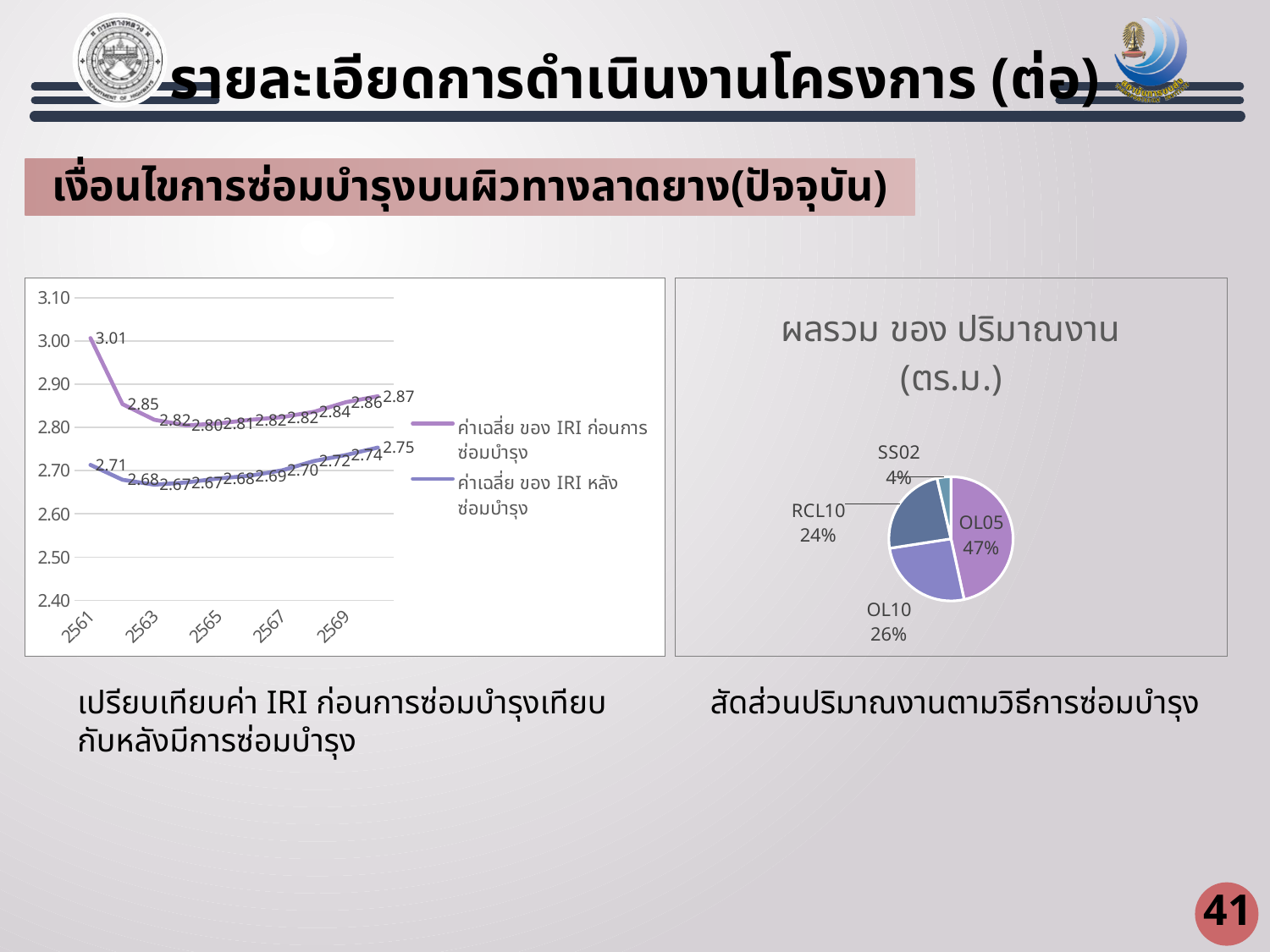
In the pie chart on the right, what share does OL05 have? 47% In the pie chart on the right, which category has the smallest slice? SS02 How many slices does the pie chart on the right have? 4 In the pie chart on the right, what is the difference between the shares of OL10 and SS02? 22% In the pie chart on the right, which category has the largest slice? OL05 In the line chart on the left, what is the difference between the two series at 2561 (3.01 and 2.71)? 0.30 In the line chart on the left, which series has the higher value at 2561: ค่าเฉลี่ย ของ IRI ก่อนการซ่อมบำรุง or ค่าเฉลี่ย ของ IRI หลังซ่อมบำรุง? ค่าเฉลี่ย ของ IRI ก่อนการซ่อมบำรุง In the line chart on the left, what is the value of ค่าเฉลี่ย ของ IRI ก่อนการซ่อมบำรุง at 2561? 3.01 In the pie chart on the right, what share does RCL10 have? 24% What kind of chart is the chart on the right? pie chart How many series does the legend of the chart on the left list? 2 What kind of chart is the chart on the left? line chart